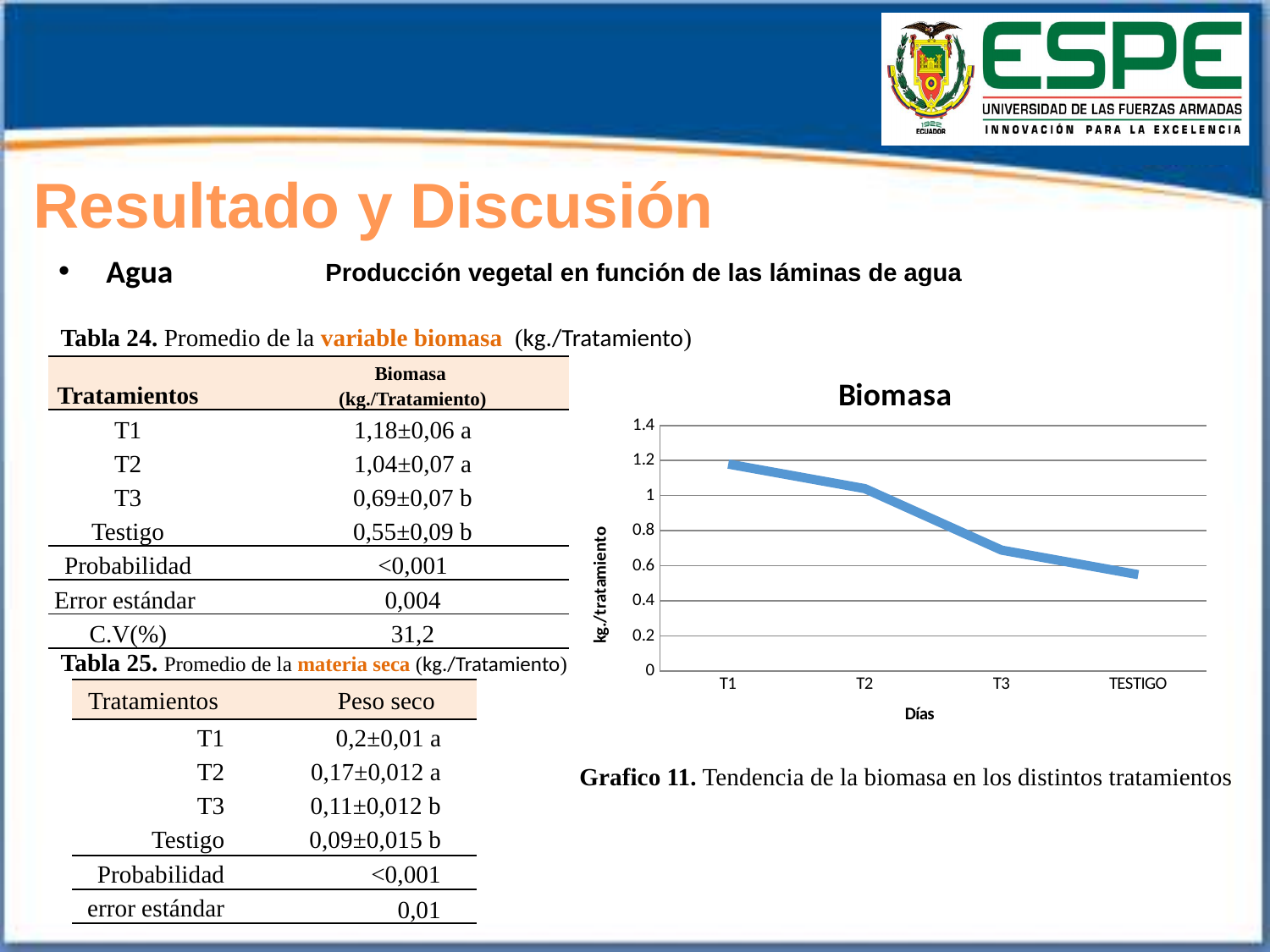
What is the label of the x axis of the 'Biomasa' chart? Días Which treatment has the highest biomass in the 'Biomasa' chart? T1 In the 'Biomasa' chart, do the values rise or fall from T1 to TESTIGO? fall Which treatment has the lowest biomass in the 'Biomasa' chart? TESTIGO In the 'Biomasa' chart, which is larger, the value for T1 or the value for T3? T1 In the 'Biomasa' chart, is the value for T2 greater or less than 1.2? less In the 'Biomasa' chart, is the value for T1 greater or less than 1? greater What is the label of the y axis of the 'Biomasa' chart? kg./tratamiento In the 'Biomasa' chart, is the value for TESTIGO greater or less than 0.8? less How many treatments are plotted along the x axis of the 'Biomasa' chart? 4 What type of chart is the 'Biomasa' chart? line chart